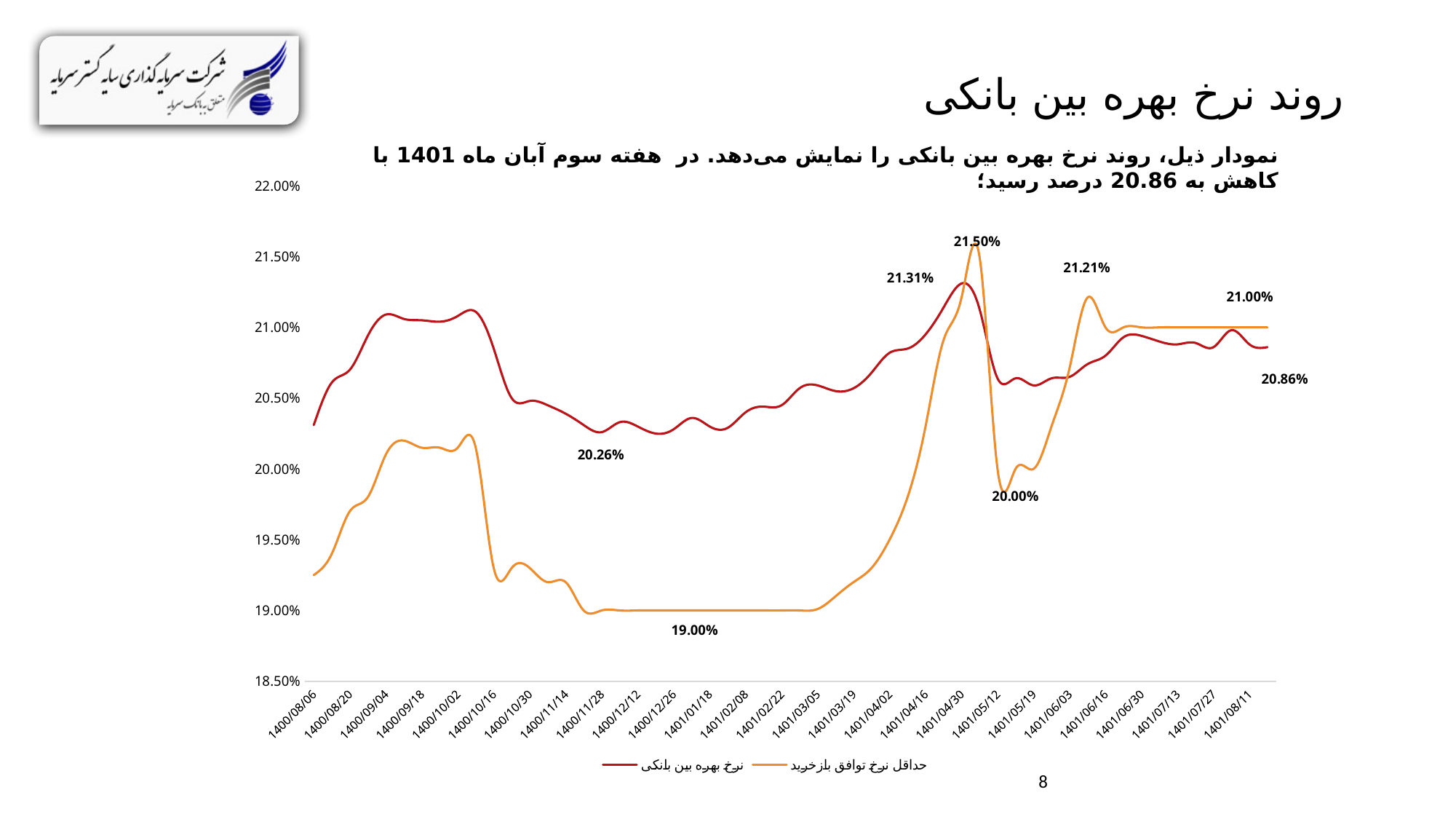
At the right end of the chart, which series is higher: the interbank interest rate or the minimum repo agreement rate? Minimum repo agreement rate (حداقل نرخ توافق بازخرید) What is the difference between the peak of the minimum repo agreement rate (21.50%) and the peak of the interbank interest rate (21.31%)? 0.19 percentage points What is the lowest labelled value of the interbank interest rate series? 20.26% What is the final labelled value of the minimum repo agreement rate (حداقل نرخ توافق بازخرید) series at the right end of the chart? 21.00% What is the title of the chart on the slide? روند نرخ بهره بین بانکی What is the highest labelled value reached by the minimum repo agreement rate series? 21.50% What type of chart is shown on the slide? Line chart Is the value of the interbank interest rate series at 1400/08/06 greater or less than 20.50%? less How many series does the legend list? 2 What is the lowest labelled value of the minimum repo agreement rate series? 19.00% What is the final labelled value of the interbank interest rate (نرخ بهره بین بانکی) series at the right end of the chart? 20.86% What is the highest labelled value reached by the interbank interest rate series? 21.31%